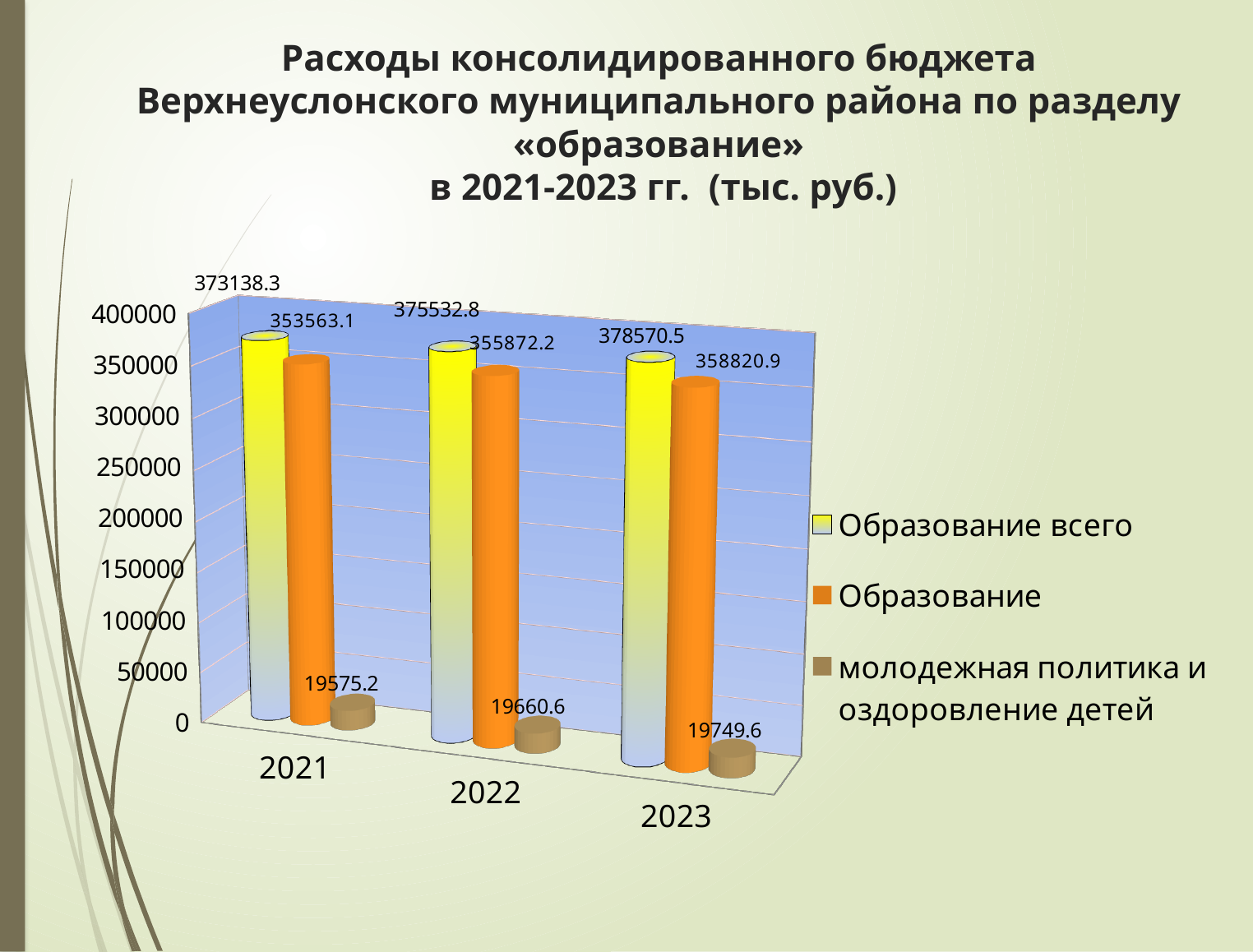
Is the value for «Образование» in 2021 greater or less than 300000? greater Which is larger in 2022: «Образование всего» or «Образование»? Образование всего In which year is the value for «молодежная политика и оздоровление детей» the lowest? 2021 What is the value for «Образование» in 2023? 358820.9 How many years are shown on the x axis? 3 What is the difference between the «Образование всего» values for 2023 and 2021? 5432.2 In which year is the value for «Образование всего» the highest? 2023 Does the value for «Образование всего» rise or fall from 2021 to 2023? rise What is the difference between the «Образование» values for 2023 and 2021? 5257.8 What is the value for «Образование всего» in 2021? 373138.3 How many series does the legend list? 3 What is the value for «молодежная политика и оздоровление детей» in 2022? 19660.6